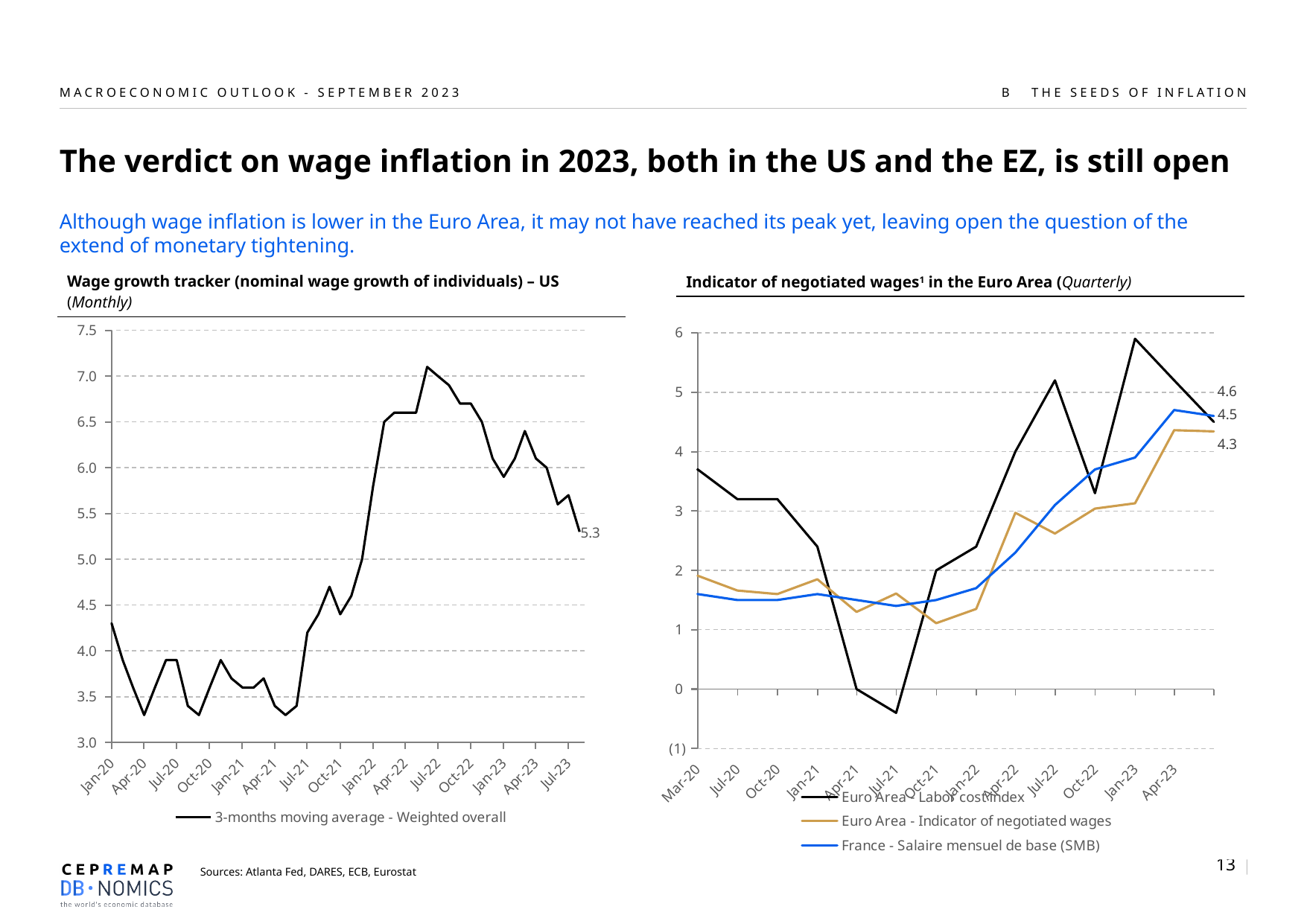
How many series does the legend of the left chart (US wage growth tracker) list? 1 On the left chart (US wage growth tracker), is the value for Apr-21 greater or less than 4.0? less On the left chart (US wage growth tracker), does the series rise or fall between Jul-22 and Jul-23? fall On the right chart (Euro Area), what is the difference between the last labelled values of the Labor cost index (4.6) and the Indicator of negotiated wages (4.3)? 0.2 What kind of chart is the left chart, 'Wage growth tracker (nominal wage growth of individuals) – US'? line chart On the right chart (Euro Area), what is the last labelled value of the Euro Area - Indicator of negotiated wages series? 4.3 On the left chart (US wage growth tracker), what is the last labelled value, for Jul-23? 5.3 How many series does the legend of the right chart (Indicator of negotiated wages in the Euro Area) list? 3 On the right chart (Euro Area), is the Euro Area - Labor cost index value for Jul-21 greater or less than 0? less On the right chart (Euro Area), what is the last labelled value of the Euro Area - Labor cost index series? 4.5 On the left chart (US wage growth tracker), is the value for Jan-20 greater or less than 4.0? greater